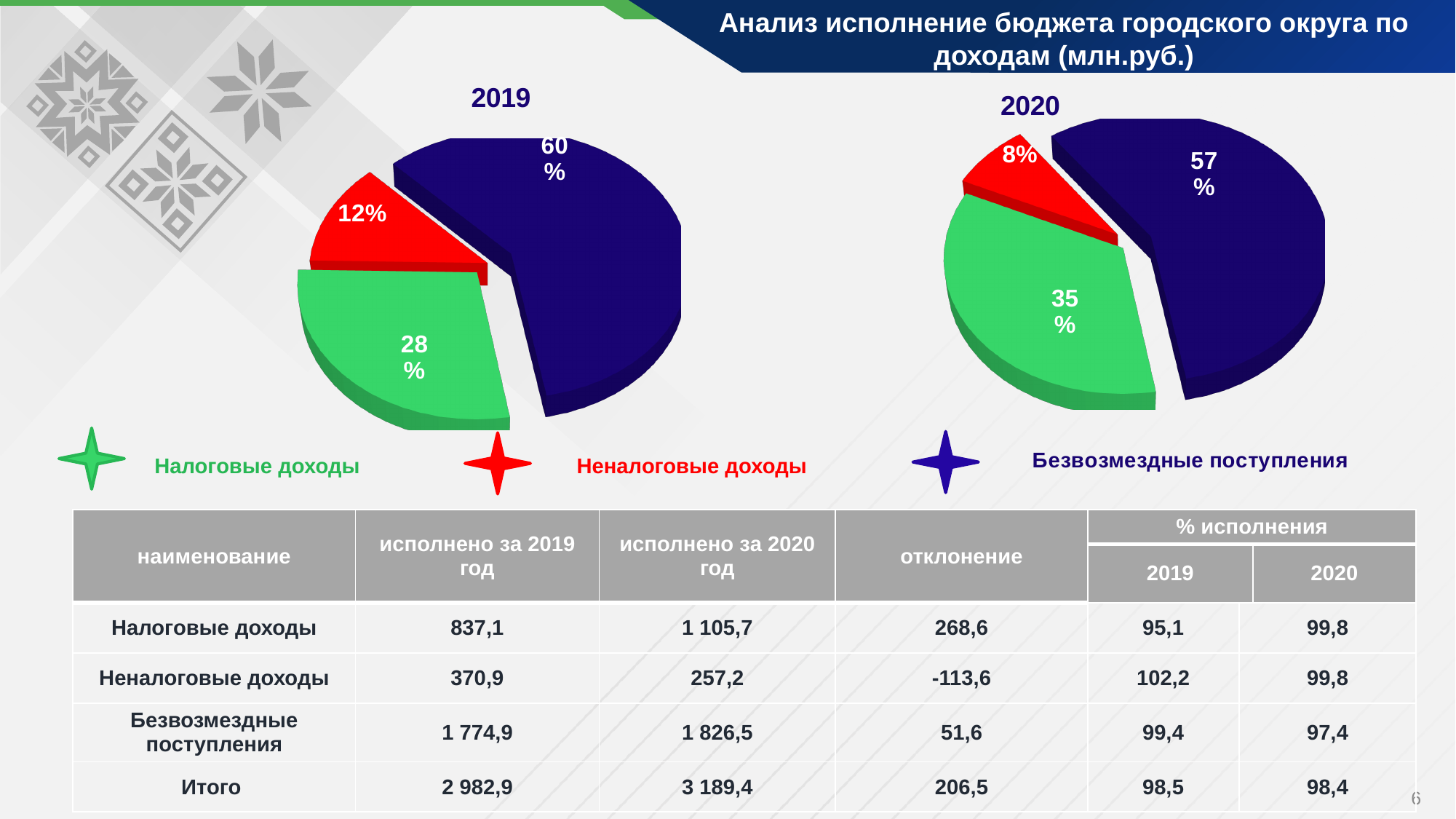
In the 2019 pie chart, what is the difference in percentage points between Безвозмездные поступления and Налоговые доходы? 32 In the 2020 pie chart, what share does Налоговые доходы have? 35% In the 2019 pie chart, what share does Неналоговые доходы have? 12% In the 2020 pie chart, which category has the largest slice? Безвозмездные поступления In the 2020 pie chart, what share does Неналоговые доходы have? 8% How many slices does the 2020 pie chart have? 3 In the 2019 pie chart, which category has the smallest slice? Неналоговые доходы What kind of chart is the 2019 chart? pie chart Which colour represents Налоговые доходы in the pie charts? green